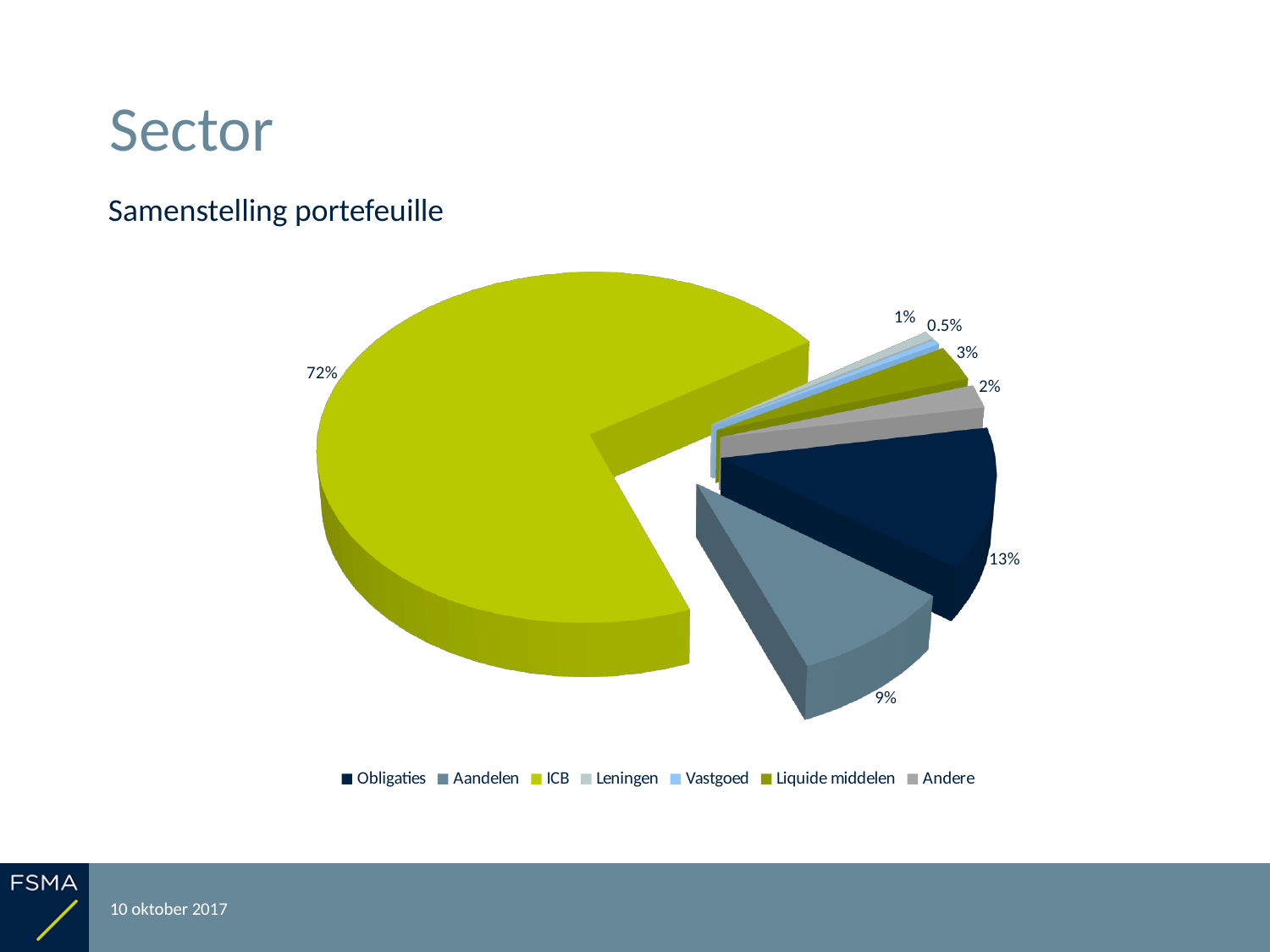
How many categories does the legend list? 7 Which is larger, the share for Liquide middelen or the share for Andere? Liquide middelen What percentage is shown for Andere? 2% What percentage is shown for Liquide middelen? 3% What share of the portfolio does ICB represent in the pie chart? 72% Which category has the largest slice of the pie? ICB What percentage is shown for Obligaties? 13% What percentage is shown for Aandelen? 9% Which category has the smallest slice of the pie? Vastgoed By how many percentage points does Obligaties exceed Aandelen? 4 percentage points What is the title of the chart? Samenstelling portefeuille What type of chart is shown on the slide? Pie chart